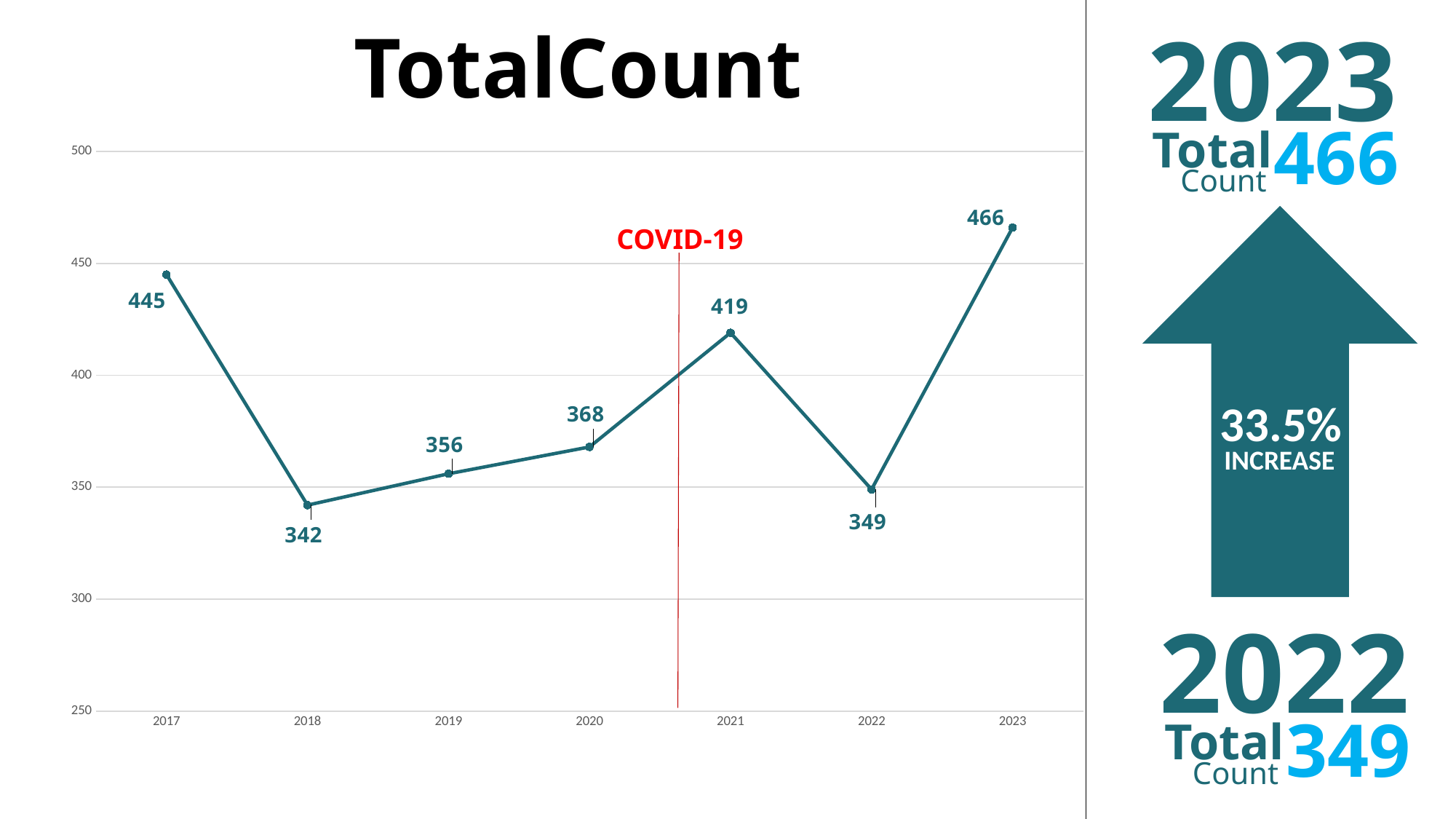
What is the total count for 2017? 445 What is the total count for 2022? 349 Does the total count rise or fall from 2018 to 2021? Rise Which year has the highest total count? 2023 What kind of chart is shown on the slide? Line chart Which year has a larger total count, 2019 or 2021? 2021 What is the difference between the total count in 2023 and in 2022? 117 How many years are plotted on the chart? 7 What label is shown on the red vertical line between 2020 and 2021? COVID-19 Which year has the lowest total count? 2018 What is the total count for 2020? 368 What is the difference between the total count in 2017 and in 2018? 103